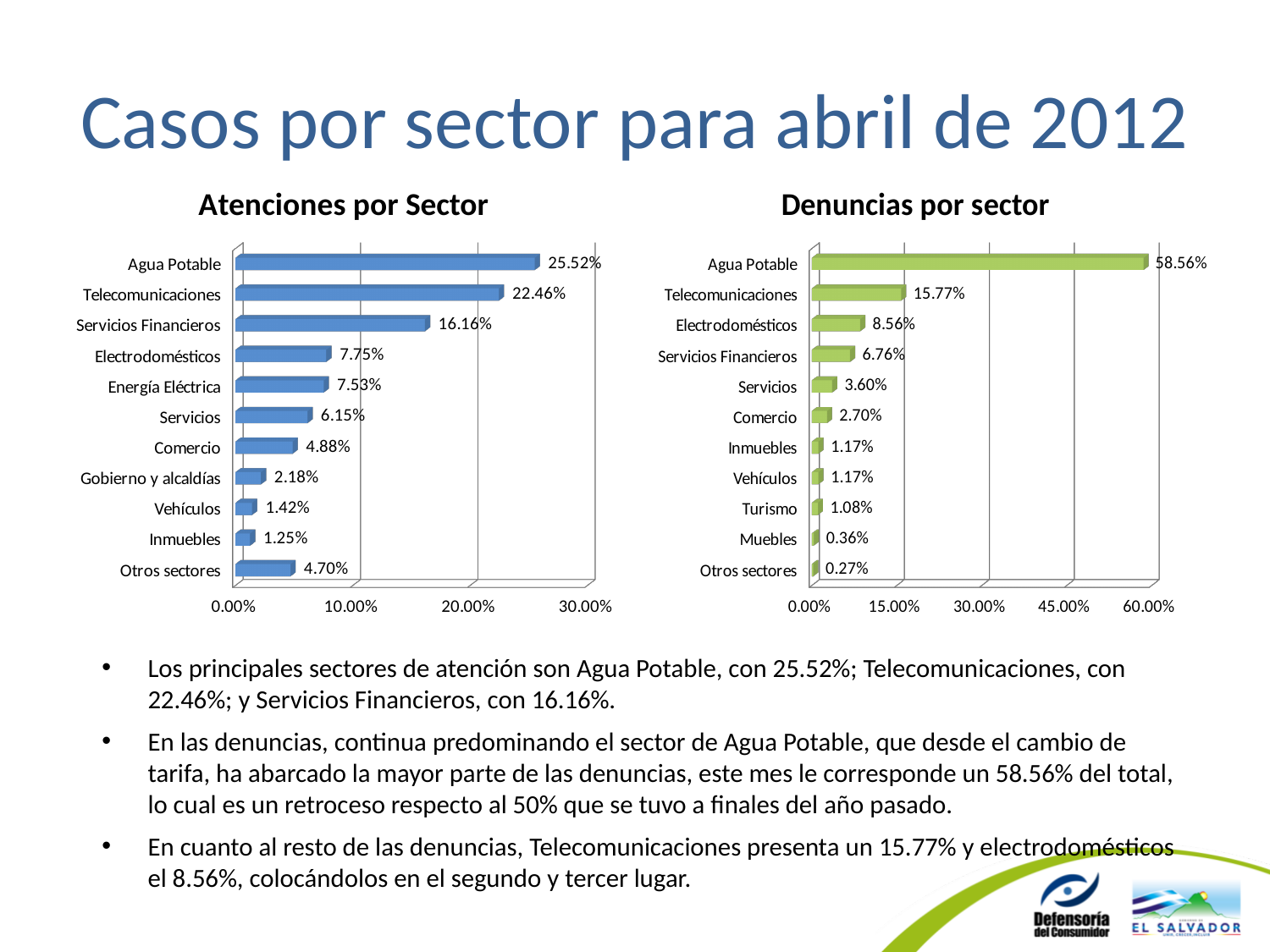
In the 'Atenciones por Sector' chart, what is the value for Telecomunicaciones? 22.46% In the 'Atenciones por Sector' chart, what is the difference between Agua Potable and Telecomunicaciones? 3.06% What type of chart is the 'Denuncias por sector' chart? Bar chart In the 'Denuncias por sector' chart, what is the value for Electrodomésticos? 8.56% How many sectors are shown in the 'Atenciones por Sector' chart? 11 What colour are the bars in the 'Atenciones por Sector' chart? Blue How many sectors are shown in the 'Denuncias por sector' chart? 11 In the 'Denuncias por sector' chart, which sector has the lowest value? Otros sectores In the 'Denuncias por sector' chart, is the value for Agua Potable greater or less than 45.00%? greater In the 'Atenciones por Sector' chart, which sector has the highest value? Agua Potable In the 'Denuncias por sector' chart, what is the difference between Agua Potable and Telecomunicaciones? 42.79% In the 'Atenciones por Sector' chart, which is larger: Electrodomésticos or Energía Eléctrica? Electrodomésticos